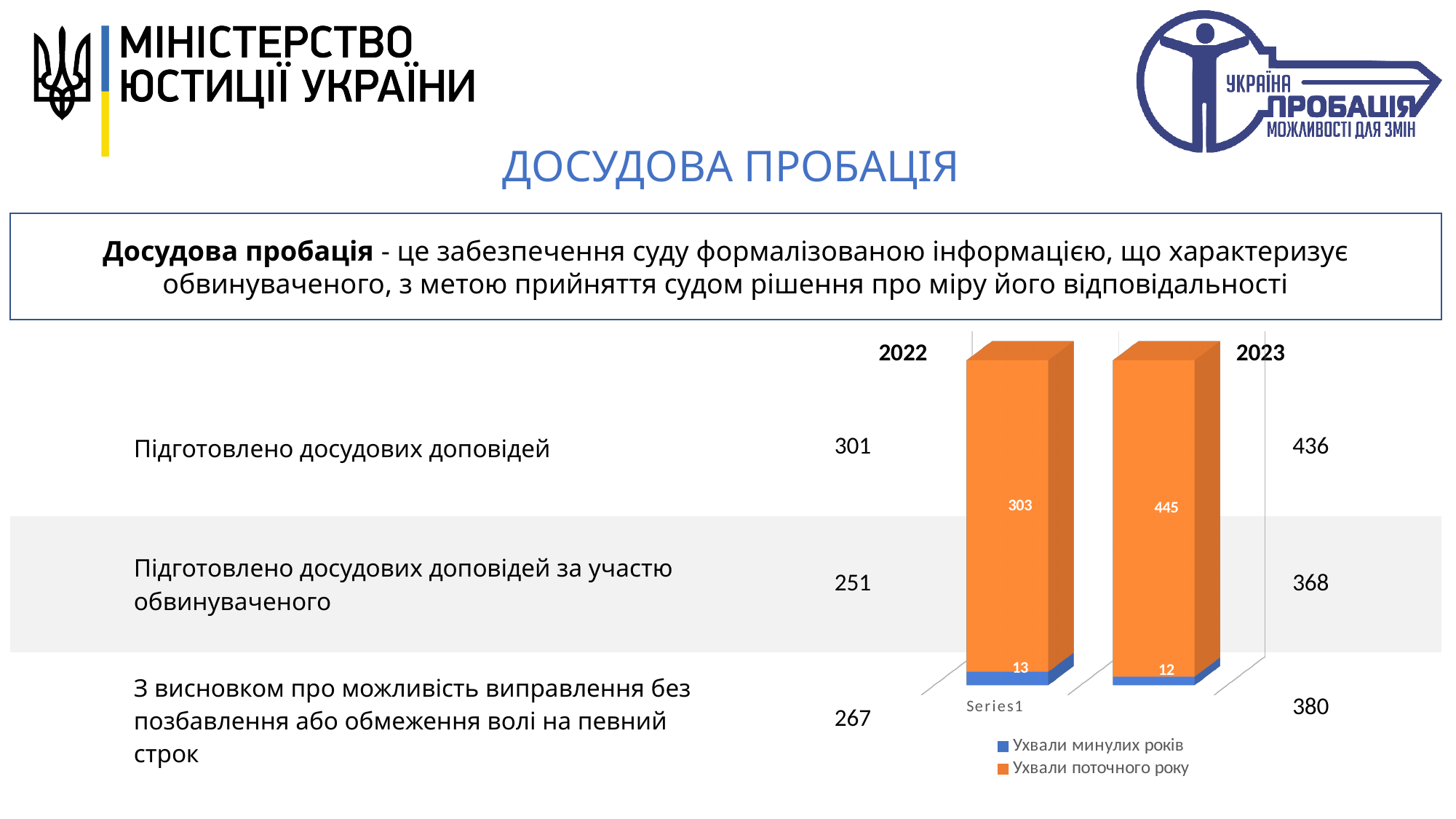
What is the value of the "Ухвали минулих років" segment in the 2023 bar? 12 By how much does the "Ухвали поточного року" value for 2023 exceed the value for 2022? 142 What is the value of the "Ухвали поточного року" segment in the 2023 bar? 445 Which year has the larger "Ухвали поточного року" value, 2022 or 2023? 2023 What is the difference between the "Ухвали минулих років" values for 2022 and 2023? 1 What kind of chart is shown on the slide? Stacked bar chart What is the total of the stacked bar for 2022? 316 What colour represents the "Ухвали минулих років" series in the chart? Blue What is the total of the stacked bar for 2023? 457 What is the value of the "Ухвали поточного року" segment in the 2022 bar? 303 What is the value of the "Ухвали минулих років" segment in the 2022 bar? 13 How many series does the chart legend list? 2